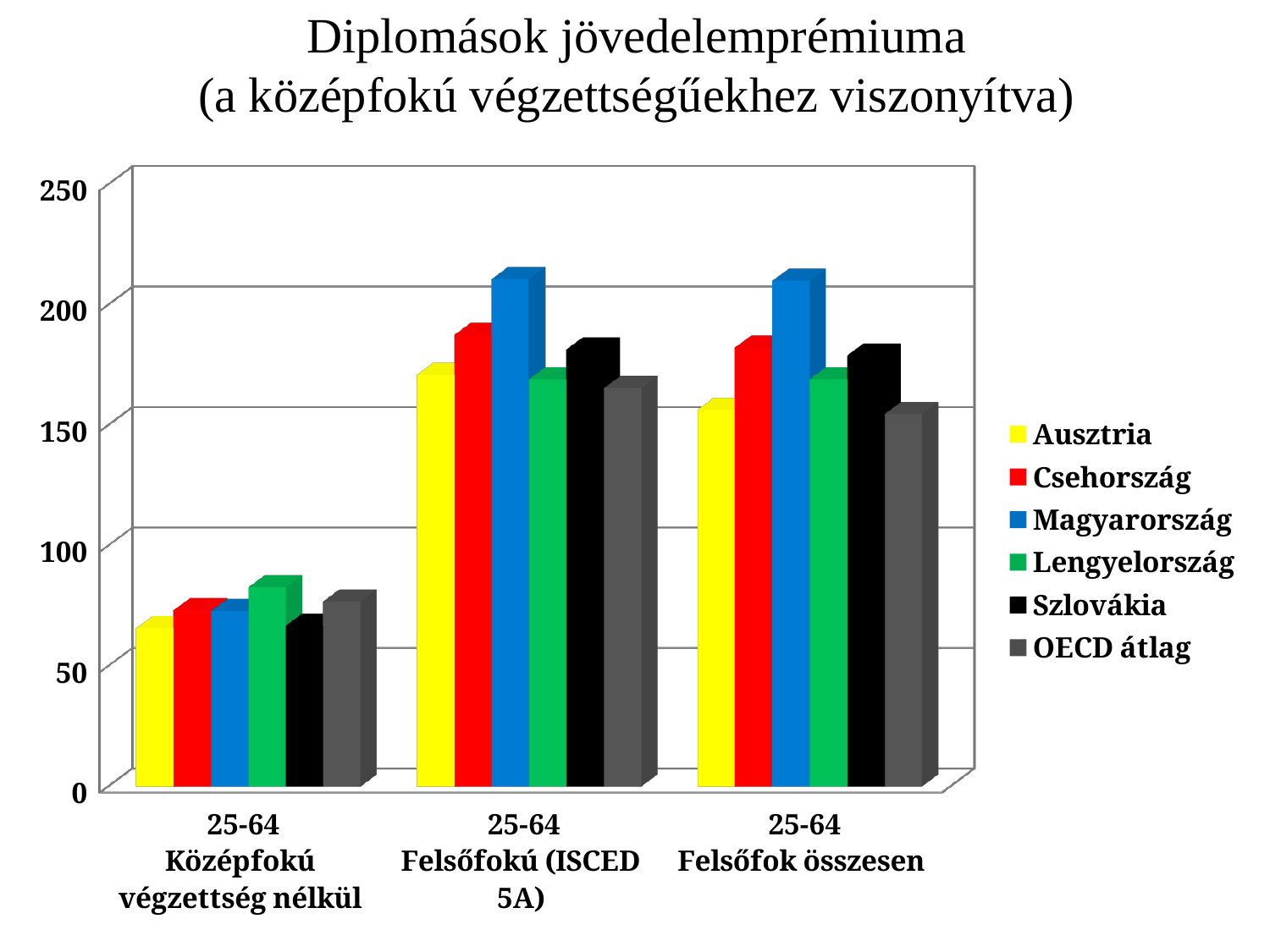
Is the value for Magyarország in the '25-64 Felsőfokú (ISCED 5A)' category greater or less than 200? greater Which country has the highest value in the '25-64 Felsőfokú (ISCED 5A)' category? Magyarország Which series has the highest value in the '25-64 Felsőfok összesen' category? Magyarország How many categories are shown on the x axis? 3 Which colour represents Szlovákia in the legend? black In the '25-64 Felsőfokú (ISCED 5A)' category, which is larger: Magyarország or Ausztria? Magyarország Is the value for OECD átlag in the '25-64 Középfokú végzettség nélkül' category greater or less than 100? less Is the value for Csehország in the '25-64 Felsőfokú (ISCED 5A)' category greater or less than 200? less What kind of chart is shown on the slide? bar chart How many series does the legend list? 6 In the '25-64 Felsőfok összesen' category, which is larger: Csehország or OECD átlag? Csehország